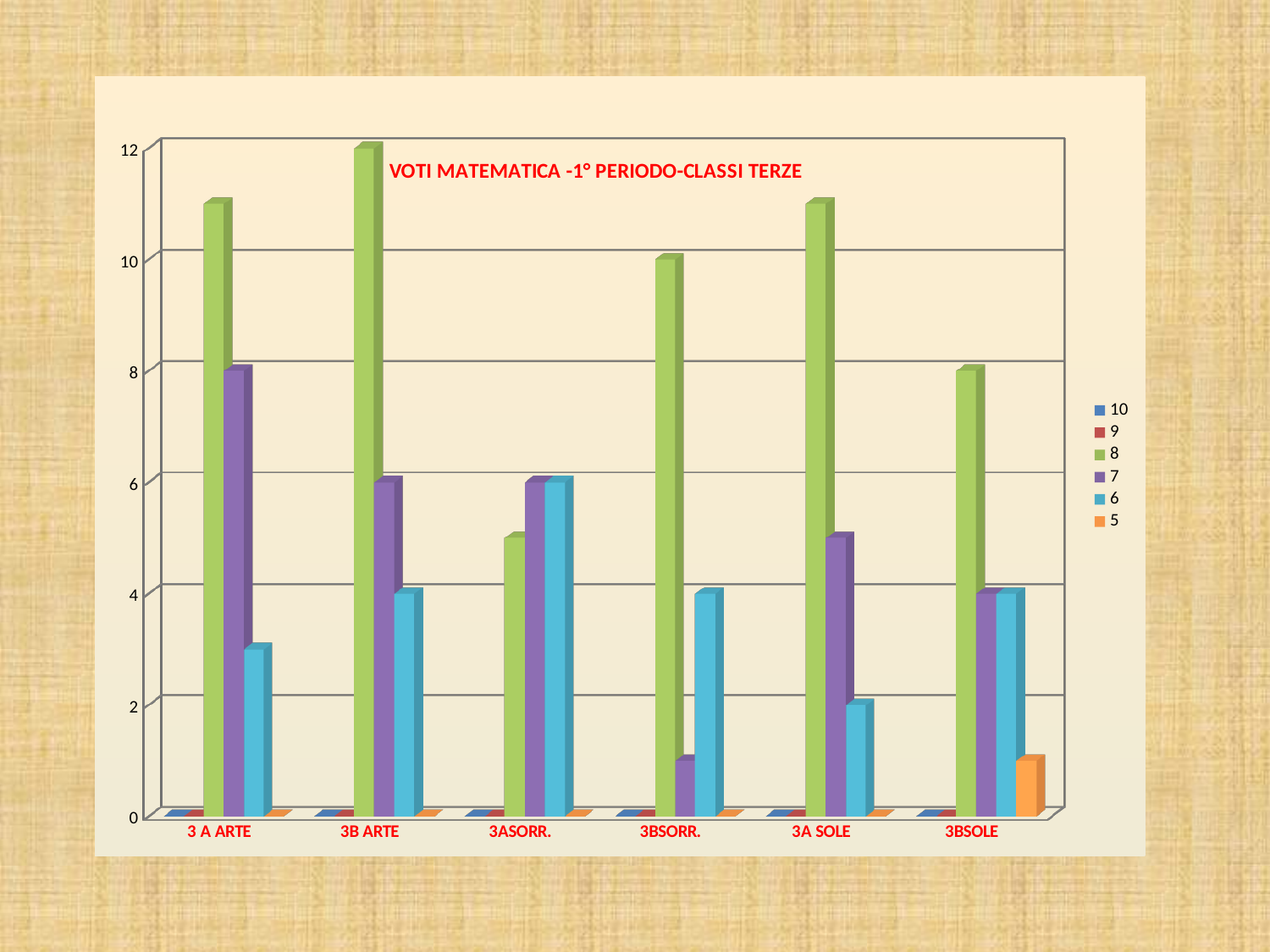
Which class has the lowest bar for series 8? 3ASORR. Is the value of series 8 for 3A SOLE greater or less than 10? greater Which class has the highest bar for series 8? 3B ARTE Which is larger for 3 A ARTE: the bar for series 8 or the bar for series 7? series 8 Is the value of series 7 for 3BSORR. greater or less than 2? less How many classes (categories) are shown on the x axis? 6 Which class is the only one with a visible bar for series 5? 3BSOLE How many series does the legend list? 6 What kind of chart is shown on the slide? bar chart What is the title of the chart? VOTI MATEMATICA -1° PERIODO-CLASSI TERZE Which is larger for 3A SOLE: the bar for series 7 or the bar for series 6? series 7 Is the value of series 6 for 3 A ARTE greater or less than 4? less